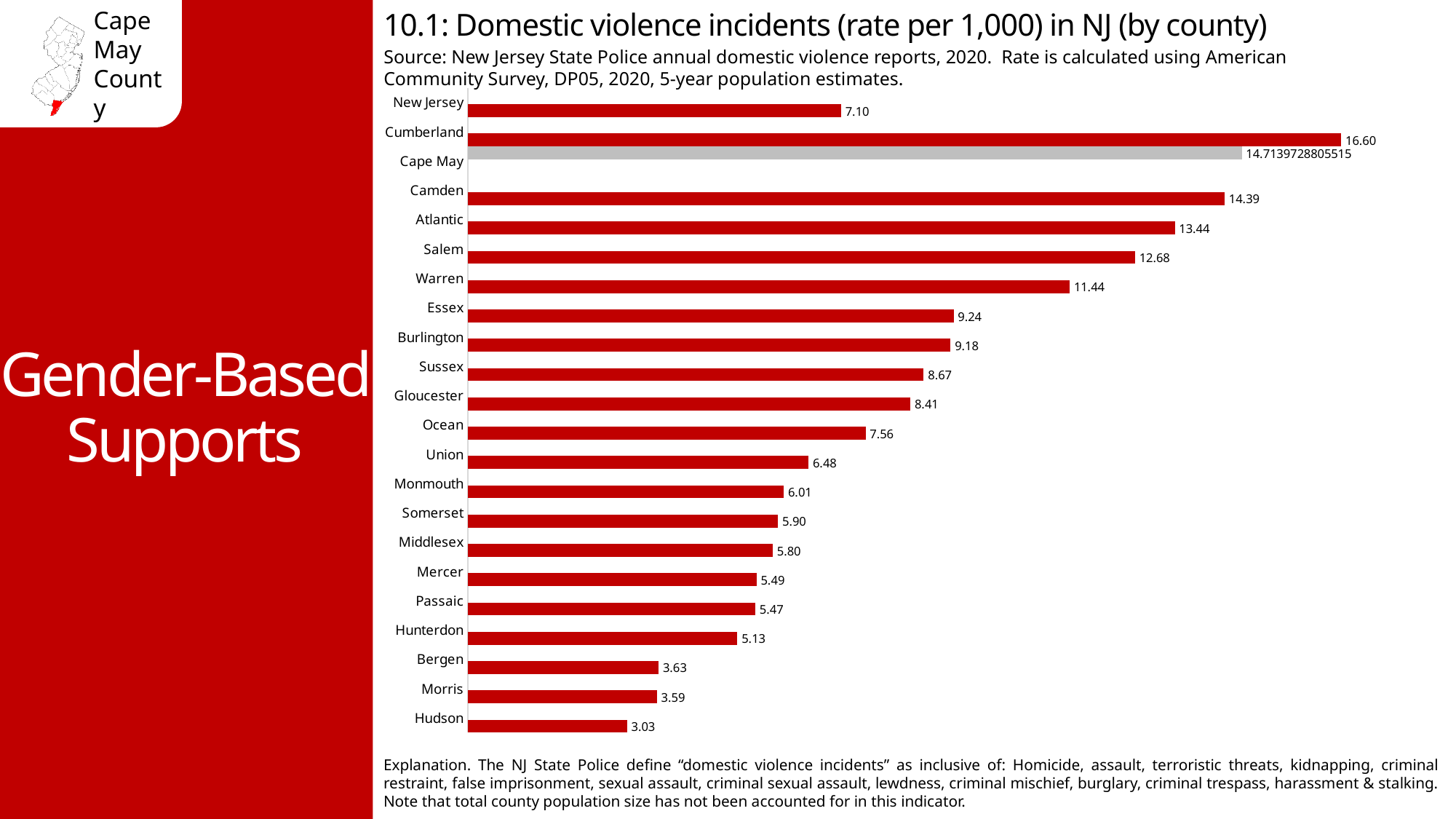
How many bars (categories) are shown in the chart? 22 Which has a higher rate, Atlantic or Salem? Atlantic What is the difference between the New Jersey rate and the Hudson rate? 4.07 Which county has the lowest domestic violence incident rate? Hudson What is the value shown for Cape May? 14.7139728805515 Which bar is coloured grey instead of red? Cape May What is the domestic violence incident rate for Cumberland? 16.60 What type of chart is shown on the slide? Bar chart What is the rate shown for New Jersey overall? 7.10 Which county has the highest domestic violence incident rate? Cumberland Which has a higher rate, Ocean or Union? Ocean What is the difference between the rates for Cumberland and Camden? 2.21